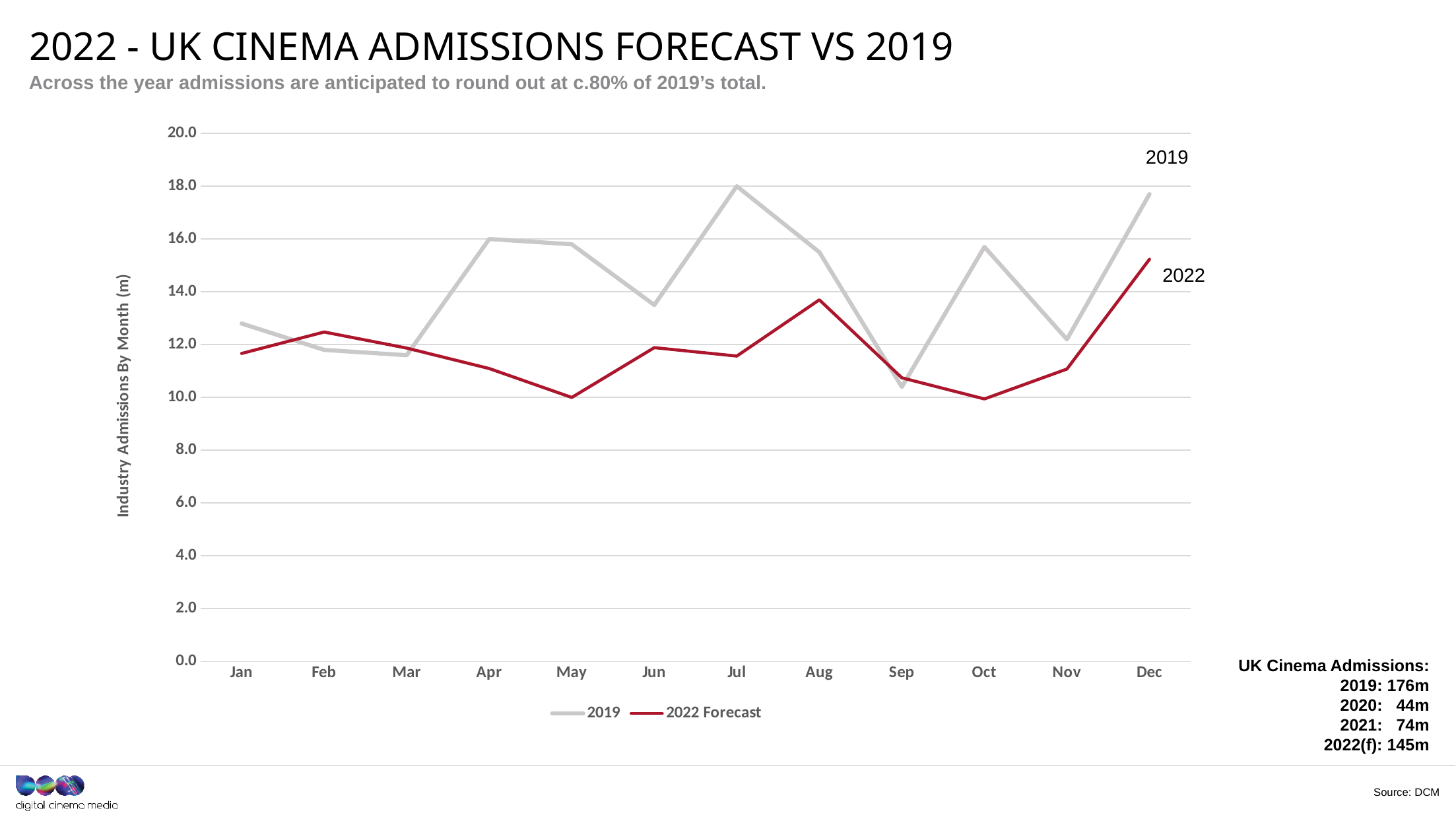
In which month does the 2022 Forecast series reach its highest value? Dec In which month does the 2019 series reach its lowest value? Sep In which month does the 2019 series reach its highest value? Jul In Apr, which series has the larger value, 2019 or 2022 Forecast? 2019 How many series does the legend list? 2 Does the 2019 series rise or fall from Sep to Oct? rise Is the value for 2019 in Jul greater or less than 16.0? greater How many months are plotted along the x axis? 12 What is the label on the y axis? Industry Admissions By Month (m) What kind of chart is shown on the slide? line chart Is the value for 2022 Forecast in Oct greater or less than 12.0? less In Feb, which series has the larger value, 2019 or 2022 Forecast? 2022 Forecast